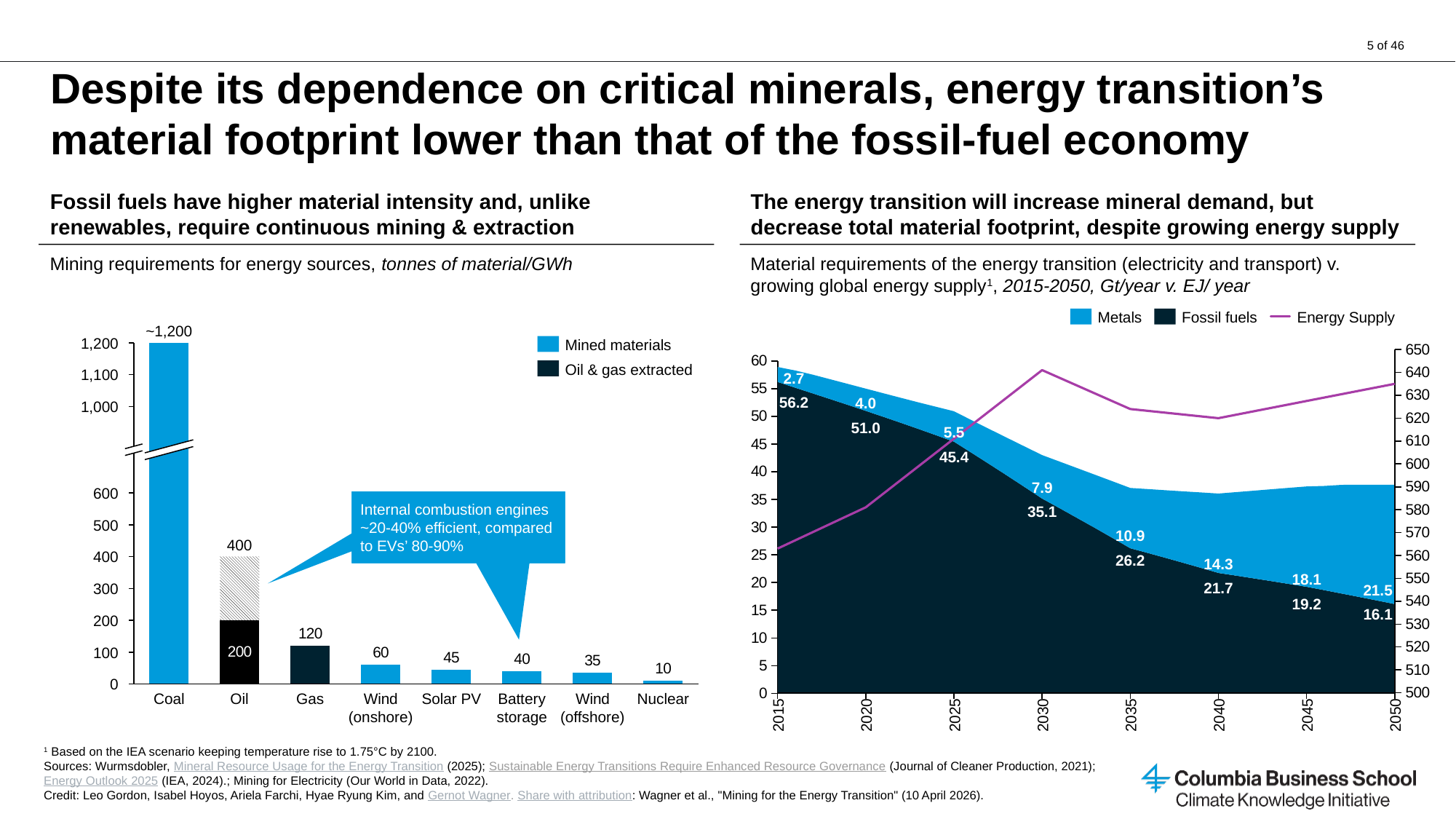
What kind of chart is the left chart (Mining requirements for energy sources)? Bar chart In the right chart (Material requirements of the energy transition), is the Energy Supply value in 2030 greater or less than 600? greater In the left chart (Mining requirements for energy sources), what is the difference between the values for Wind (onshore) and Solar PV? 15 How many energy sources are shown on the x axis of the left chart (Mining requirements for energy sources)? 8 In the right chart (Material requirements of the energy transition), what is the Metals value in 2050? 21.5 In the left chart (Mining requirements for energy sources), what is the value for Gas? 120 In the right chart (Material requirements of the energy transition), what is the combined total of Metals and Fossil fuels in 2040? 36.0 In the right chart (Material requirements of the energy transition), what is the Fossil fuels value in 2030? 35.1 How many series does the legend of the right chart (Material requirements of the energy transition) list? 3 In the left chart (Mining requirements for energy sources), which energy source has the lowest mining requirement? Nuclear In the left chart (Mining requirements for energy sources), which energy source has the highest mining requirement? Coal In the right chart (Material requirements of the energy transition), do the Fossil fuels values rise or fall from 2015 to 2050? Fall